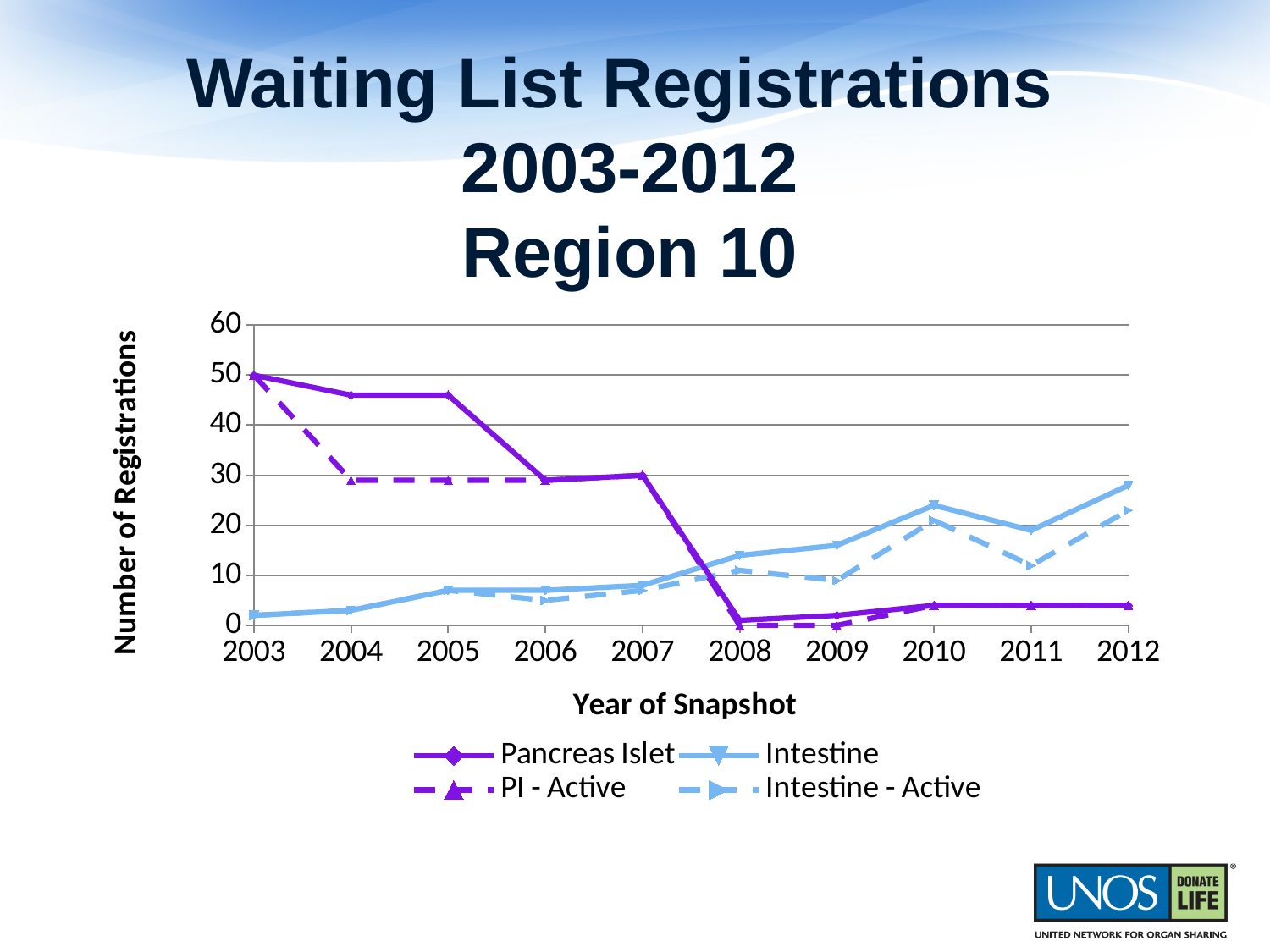
In 2012, which is larger: Intestine or Pancreas Islet? Intestine How many years are shown on the x axis? 10 Is the value for Intestine in 2012 greater or less than 20? greater Is the value for Pancreas Islet in 2004 greater or less than 40? greater Does the Pancreas Islet series rise or fall from 2003 to 2008? fall What is the value for Pancreas Islet in 2003? 50 What is the value for Pancreas Islet in 2007? 30 What kind of chart is shown on the slide? line chart How many series does the legend list? 4 In which year is the Intestine series highest? 2012 In which year is the Pancreas Islet series highest? 2003 Is the value for Intestine in 2003 greater or less than 10? less